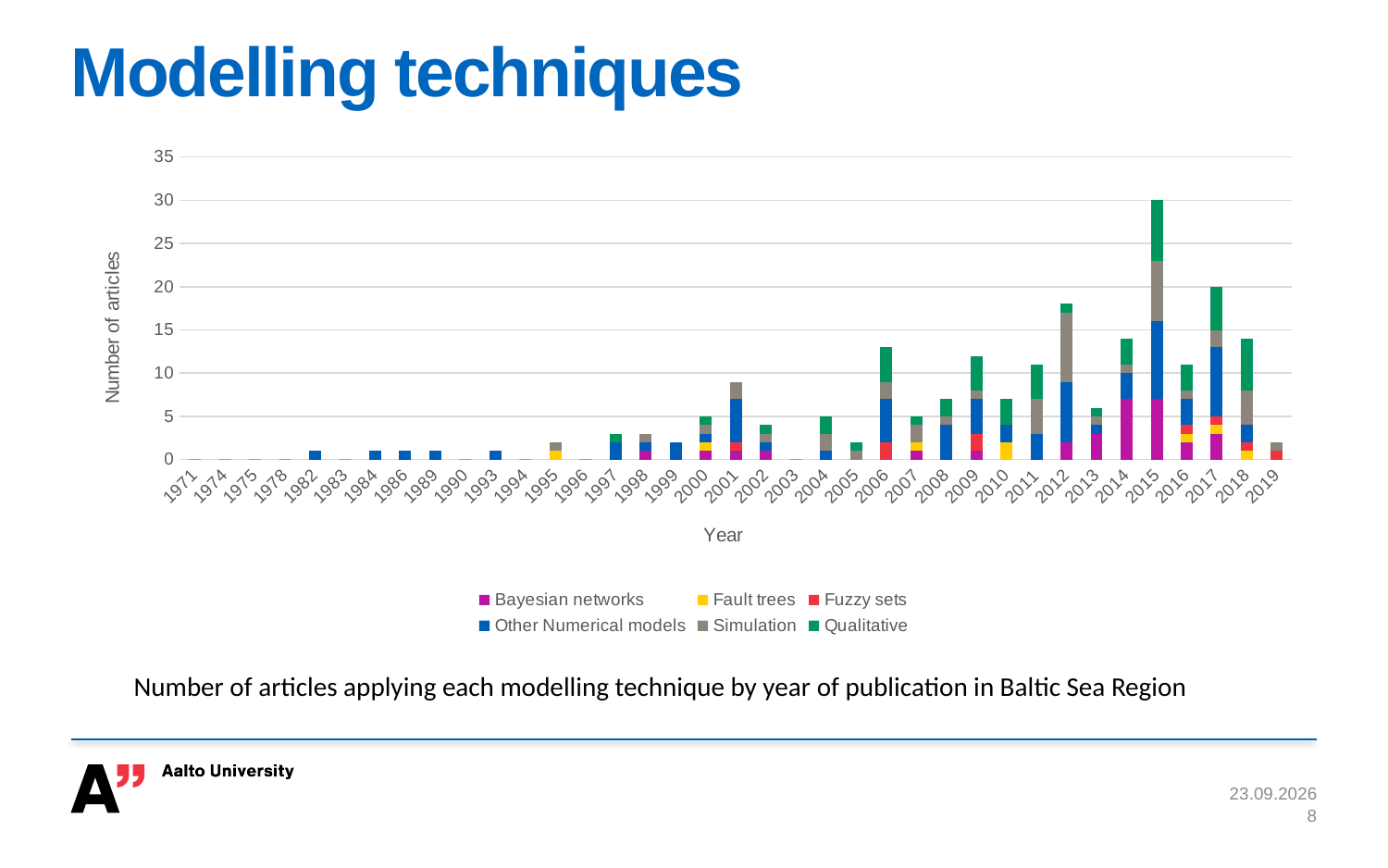
Is the total number of articles for 2018 greater or less than 15? less Which year has the highest total number of articles? 2015 Is the total number of articles for 2013 greater or less than 10? less Which year has a larger total number of articles, 2006 or 2007? 2006 Is the total number of articles for 2012 greater or less than 15? greater What is the label of the y axis? Number of articles Which year has a larger total number of articles, 2012 or 2014? 2012 How many series does the legend list? 6 How many years are shown on the x axis? 37 What is the total number of articles for 2015? 30 What kind of chart is shown on the slide? Stacked bar chart What is the total number of articles for 2017? 20